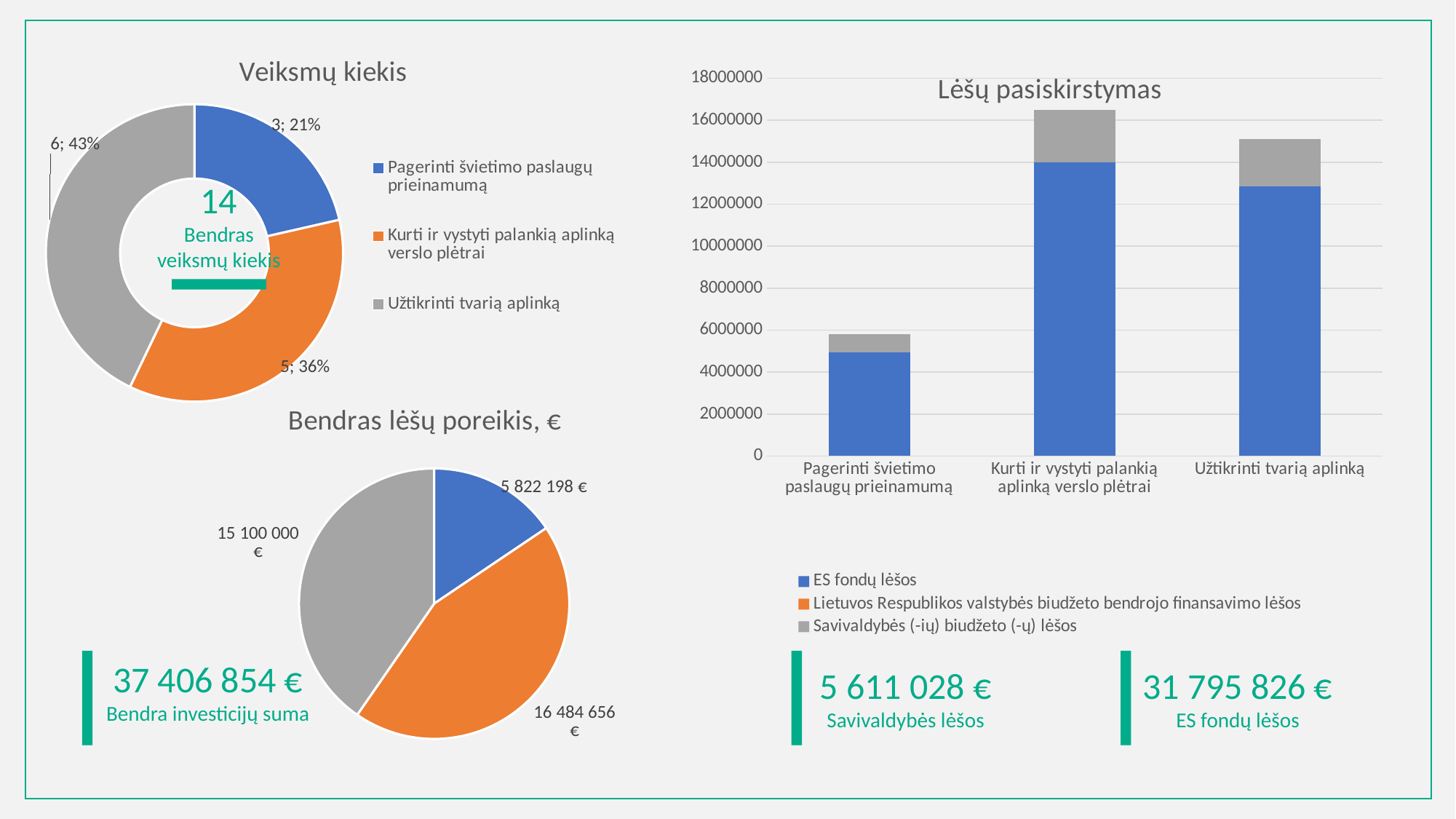
In the 'Veiksmų kiekis' chart, which category has the smallest number of actions? Pagerinti švietimo paslaugų prieinamumą In the 'Veiksmų kiekis' chart, what is the value and share shown for 'Užtikrinti tvarią aplinką'? 6; 43% In the 'Bendras lėšų poreikis, €' chart, is the 16 484 656 € slice larger or smaller than the 15 100 000 € slice? Larger In the 'Lėšų pasiskirstymas' chart, which category has the lowest total bar? Pagerinti švietimo paslaugų prieinamumą In the 'Veiksmų kiekis' chart, what is the difference between the number of actions for 'Užtikrinti tvarią aplinką' and 'Pagerinti švietimo paslaugų prieinamumą'? 3 How many categories are shown on the x axis of the 'Lėšų pasiskirstymas' chart? 3 In the 'Lėšų pasiskirstymas' chart, is the total bar for 'Kurti ir vystyti palankią aplinką verslo plėtrai' greater or less than 16000000? greater In the 'Bendras lėšų poreikis, €' chart, which slice is the smallest? 5 822 198 € What type of chart is 'Veiksmų kiekis'? Doughnut chart In the 'Veiksmų kiekis' chart, what share of the doughnut does 'Kurti ir vystyti palankią aplinką verslo plėtrai' take? 36% In the 'Bendras lėšų poreikis, €' chart, what is the value of the orange slice? 16 484 656 € How many series does the legend of the 'Lėšų pasiskirstymas' chart list? 3